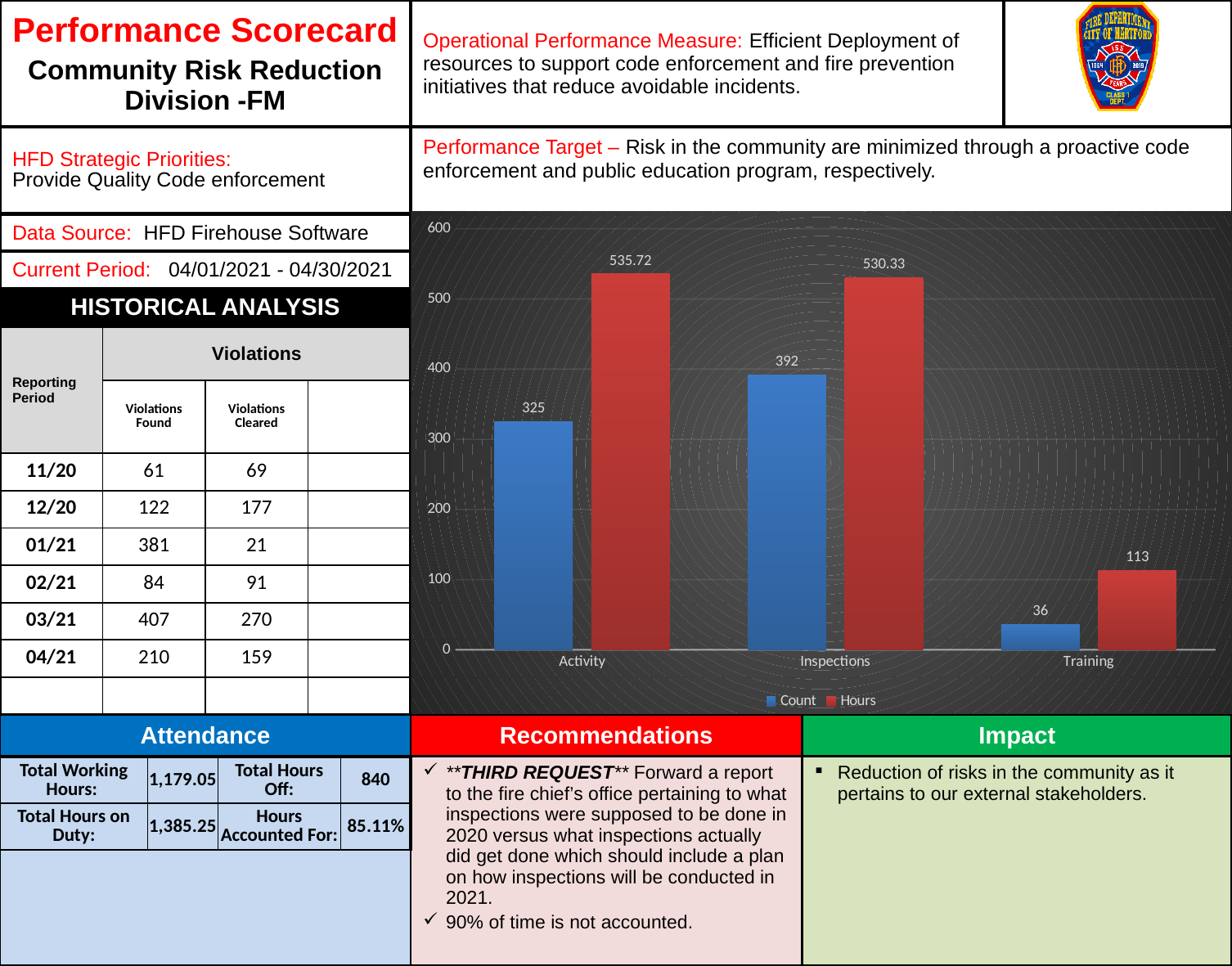
Which is larger, the Count value for Inspections or the Count value for Activity? Inspections Which category has the highest Hours value? Activity How many series does the chart legend list? 2 What is the Hours value for Inspections? 530.33 What is the Count value for Training? 36 What is the Hours value for Training? 113 What kind of chart is shown on the slide? Bar chart What is the Count value for Activity? 325 How many categories are shown on the x axis of the chart? 3 Which category has the lowest Count value? Training What are the two series named in the chart legend? Count and Hours What is the difference between the Hours value and the Count value for Activity? 210.72